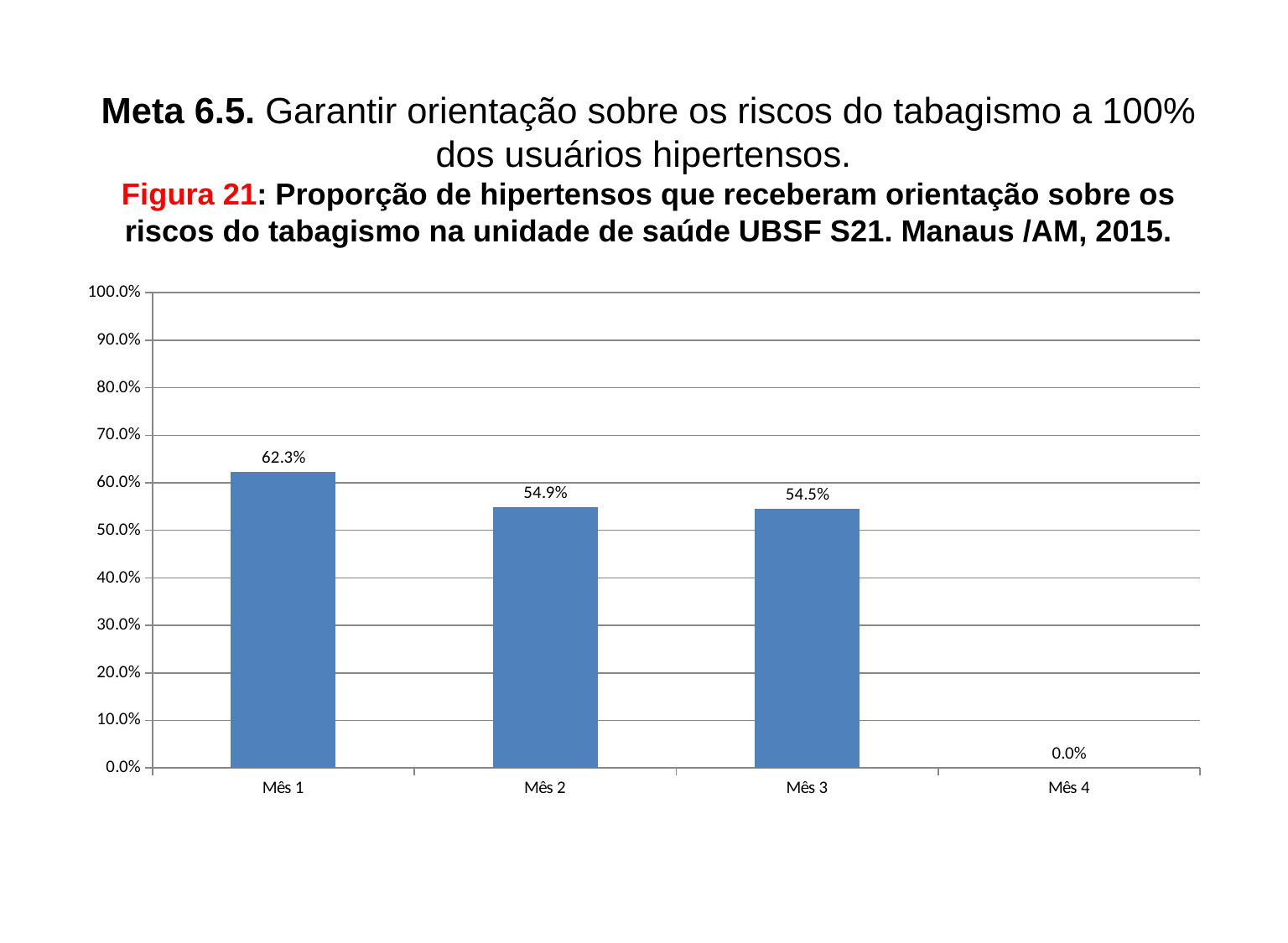
What is the value for Mês 1? 62.3% What kind of chart is shown on the slide? bar chart Which month has the highest value? Mês 1 What is the value for Mês 4? 0.0% Which is larger, the value for Mês 1 or the value for Mês 3? Mês 1 Do the values rise or fall from Mês 1 to Mês 4? fall What is the value for Mês 3? 54.5% What is the value for Mês 2? 54.9% How many months are shown on the x axis? 4 What is the difference between the values for Mês 1 and Mês 2? 7.4% Which month has the lowest value? Mês 4 Is the value for Mês 1 greater or less than 60%? greater